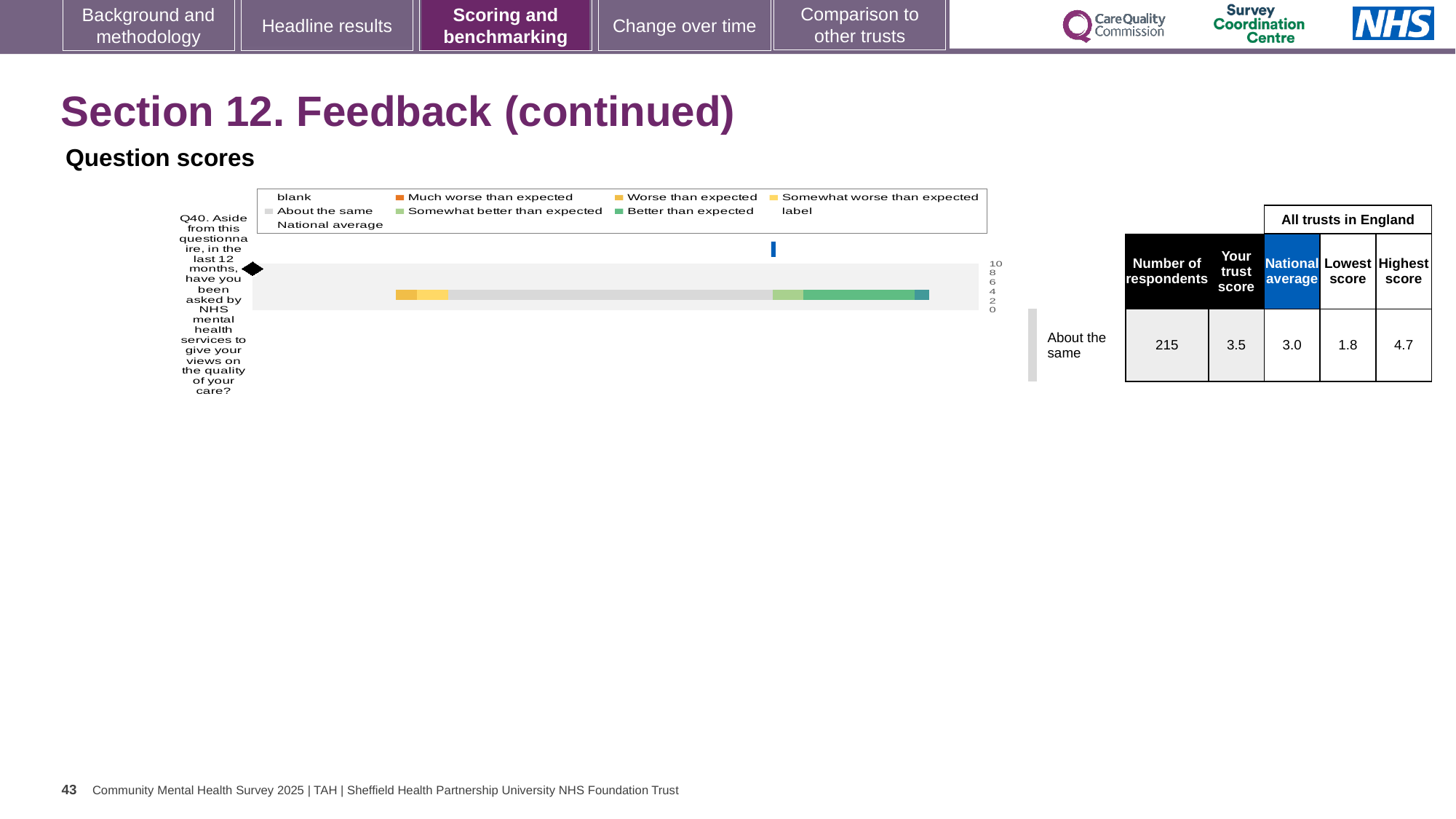
What benchmark category is shown for Q40 next to the chart? About the same How many entries does the chart legend list? 9 In the table beside the chart, what is the national average for Q40? 3.0 Which legend entry is shown in orange? Much worse than expected Which question number is plotted in the chart? Q40 In the table beside the chart, what is the number of respondents for Q40? 215 In the table beside the chart, what is your trust score for Q40? 3.5 In the table beside the chart, what is the lowest score among all trusts in England for Q40? 1.8 What kind of chart is shown on the slide? bar chart In the table beside the chart, what is the highest score among all trusts in England for Q40? 4.7 How many questions (categories) are plotted in the chart? 1 Is your trust score for Q40 larger or smaller than the national average? larger